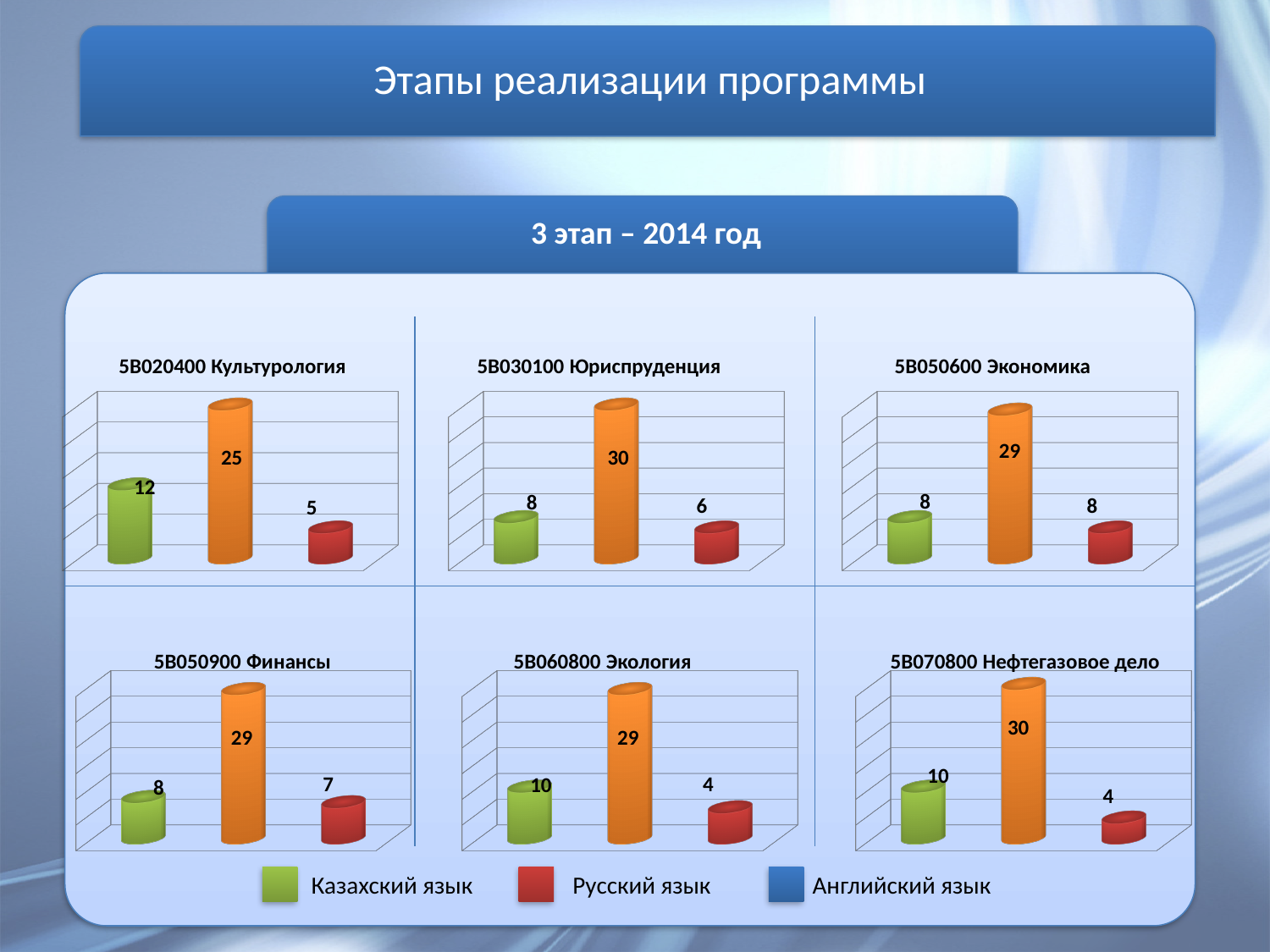
In the chart titled "5B060800 Экология", what is the difference between the green bar (Казахский язык) and the red bar (Русский язык)? 6 In the chart titled "5B020400 Культурология", what is the value of the green bar (Казахский язык)? 12 In the chart titled "5B060800 Экология", what is the value of the red bar (Русский язык)? 4 In the chart titled "5B050600 Экономика", which bar is the highest? the orange (middle) bar, 29 What type of chart is used for "5B050600 Экономика"? bar chart In the chart titled "5B030100 Юриспруденция", which is larger: the green bar (Казахский язык) or the red bar (Русский язык)? the green bar (Казахский язык), 8 In the chart titled "5B070800 Нефтегазовое дело", what is the value of the green bar (Казахский язык)? 10 In the chart titled "5B020400 Культурология", which bar is the lowest? the red bar (Русский язык), 5 In the chart titled "5B050900 Финансы", what is the difference between the orange bar and the red bar (Русский язык)? 22 How many bars are plotted in the chart titled "5B070800 Нефтегазовое дело"? 3 In the chart titled "5B030100 Юриспруденция", what is the value of the orange (middle) bar? 30 How many entries does the legend at the bottom of the slide list? 3